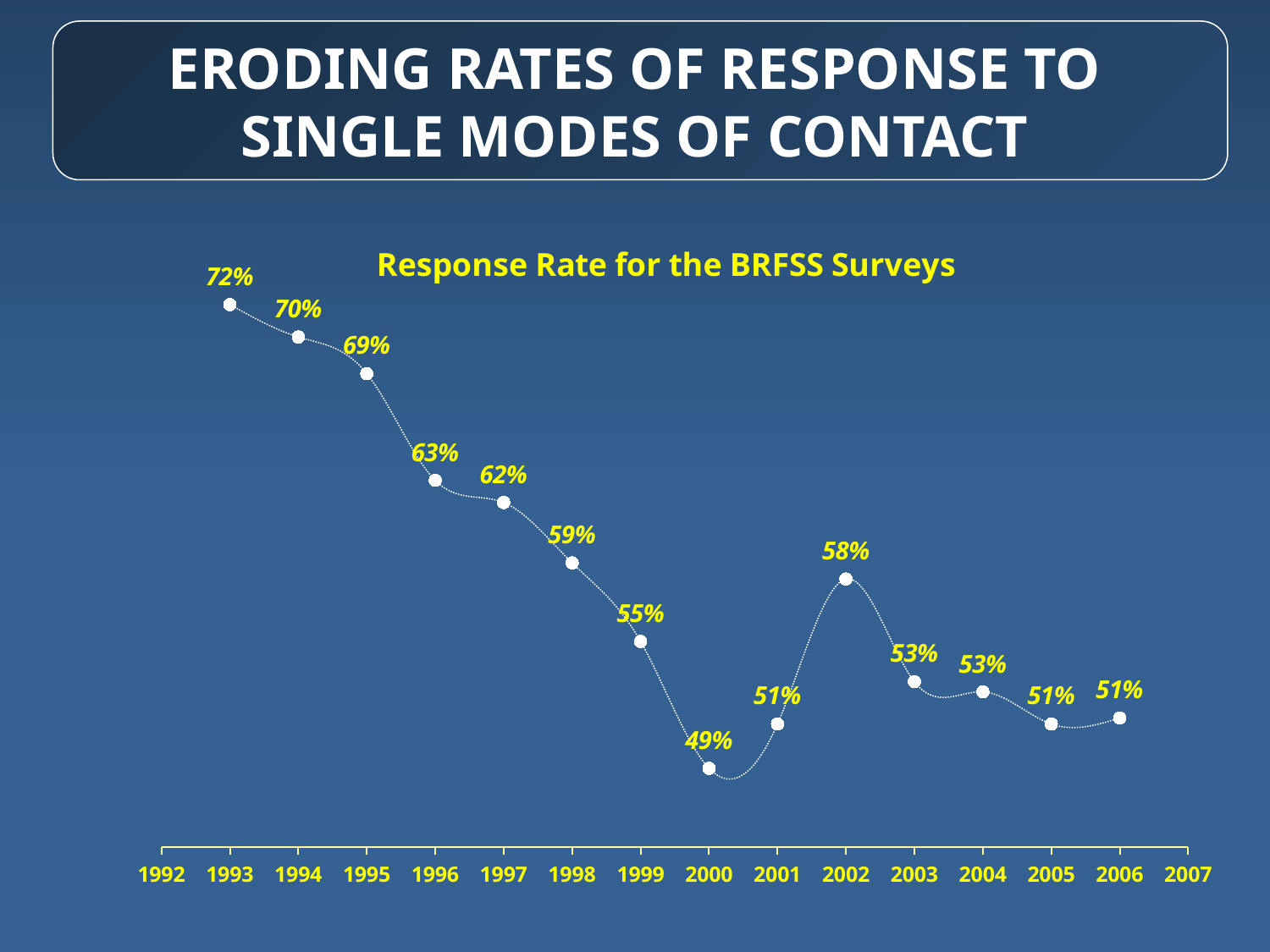
Which year has a higher response rate, 1999 or 2001? 1999 What kind of chart is shown on the slide? Line chart What is the response rate for 2002? 58% Which year has the highest response rate? 1993 What is the response rate for 2000? 49% What is the response rate for 1998? 59% What is the difference between the response rates for 1993 and 2006? 21% Which year has the lowest response rate? 2000 What is the title of the chart? Response Rate for the BRFSS Surveys What is the response rate for 1993? 72% What is the difference between the response rates for 2002 and 2003? 5% How many data points are plotted on the line? 14